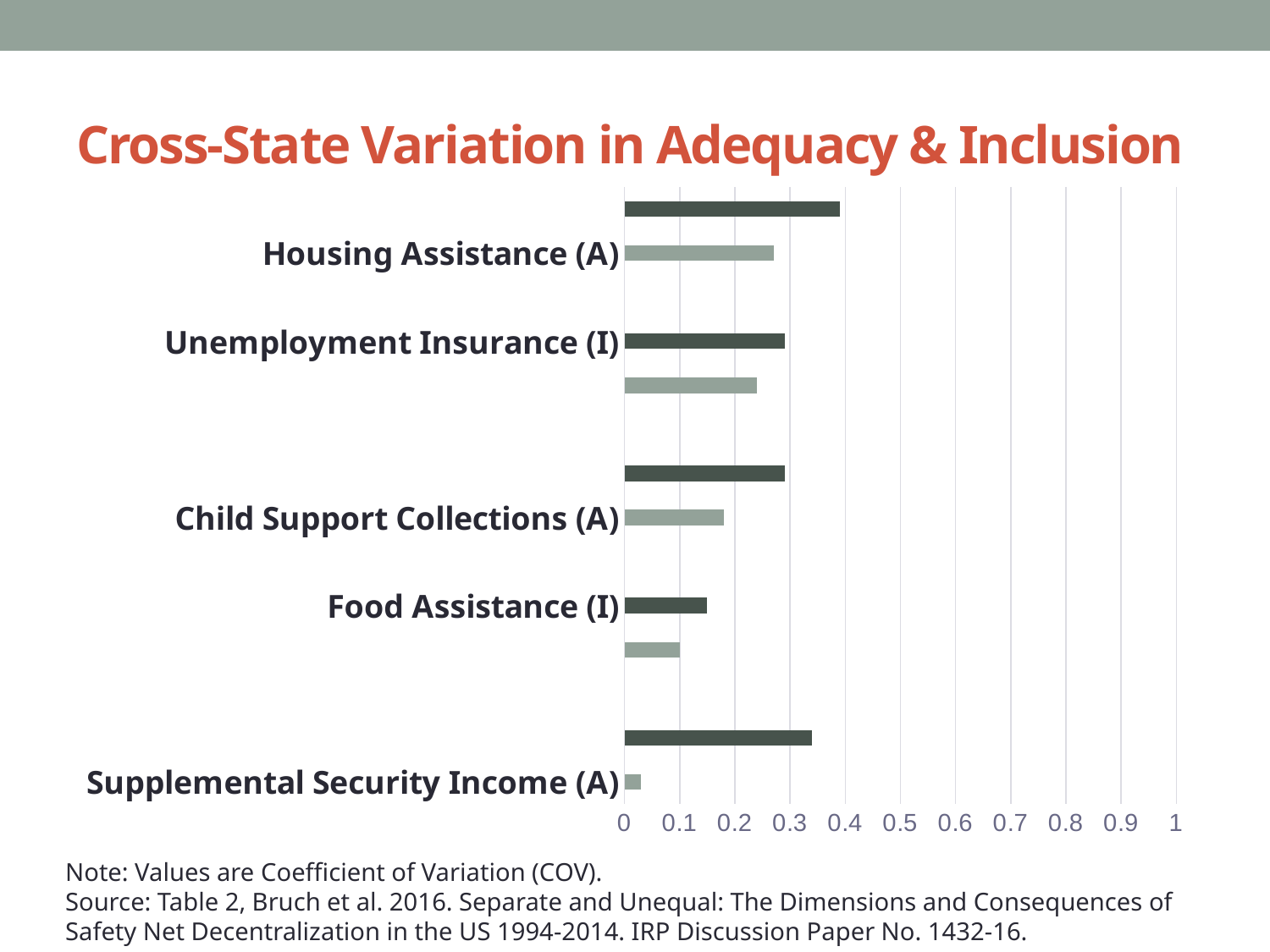
What is the title of the chart? Cross-State Variation in Adequacy & Inclusion Is the dark bar for Housing Assistance (A) greater or less than 0.3? greater Is the light bar for Supplemental Security Income (A) greater or less than 0.1? less Is the dark bar for Food Assistance (I) greater or less than 0.2? less Which category has the longest dark bar? Housing Assistance (A) What kind of chart is shown on the slide? bar chart How many categories are shown on the chart? 5 Which is larger: the dark bar for Housing Assistance (A) or the dark bar for Supplemental Security Income (A)? Housing Assistance (A) Which category has the shortest light bar? Supplemental Security Income (A) Which category has the shortest dark bar? Food Assistance (I) Which is larger: the light bar for Food Assistance (I) or the light bar for Child Support Collections (A)? Child Support Collections (A)